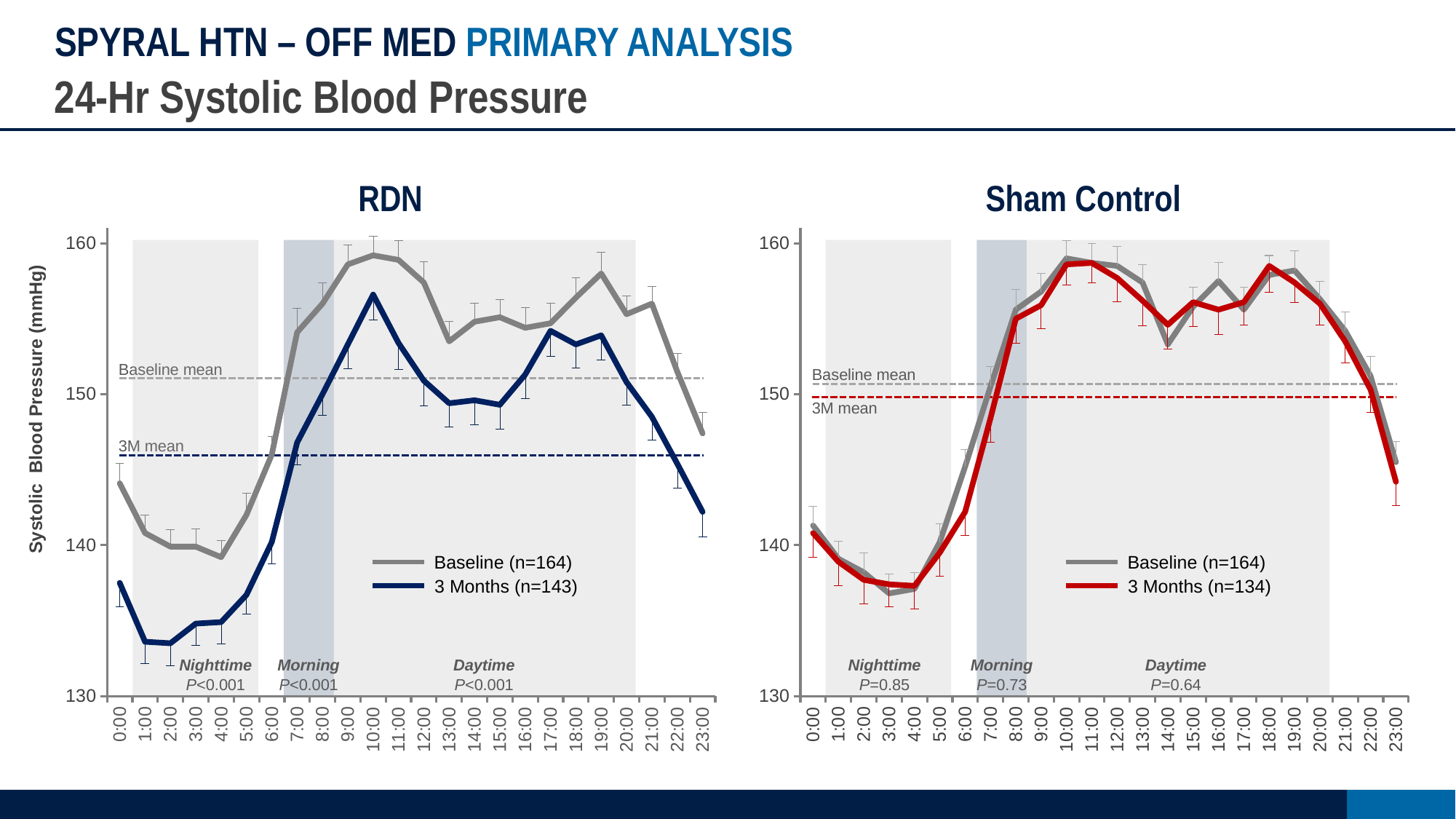
What kind of chart is the RDN chart? line chart How many series does the legend of the Sham Control chart list? 2 In the RDN chart, at 10:00, which series has the higher value, Baseline or 3 Months? Baseline In the RDN chart, what P value is shown for the Nighttime period? P<0.001 How many time points are plotted along the x axis of the RDN chart? 24 In the Sham Control chart, what is the n shown in the legend for the 3 Months series? n=134 In the RDN chart, at which time does the 3 Months series reach its highest value? 10:00 In the RDN chart, does the 3 Months series rise or fall between 2:00 and 10:00? rise In the Sham Control chart, is the Baseline value at 3:00 greater or less than 140? less In the RDN chart, is the 3 Months value at 2:00 greater or less than 140? less In the Sham Control chart, is the 3 Months value at 23:00 greater or less than 150? less